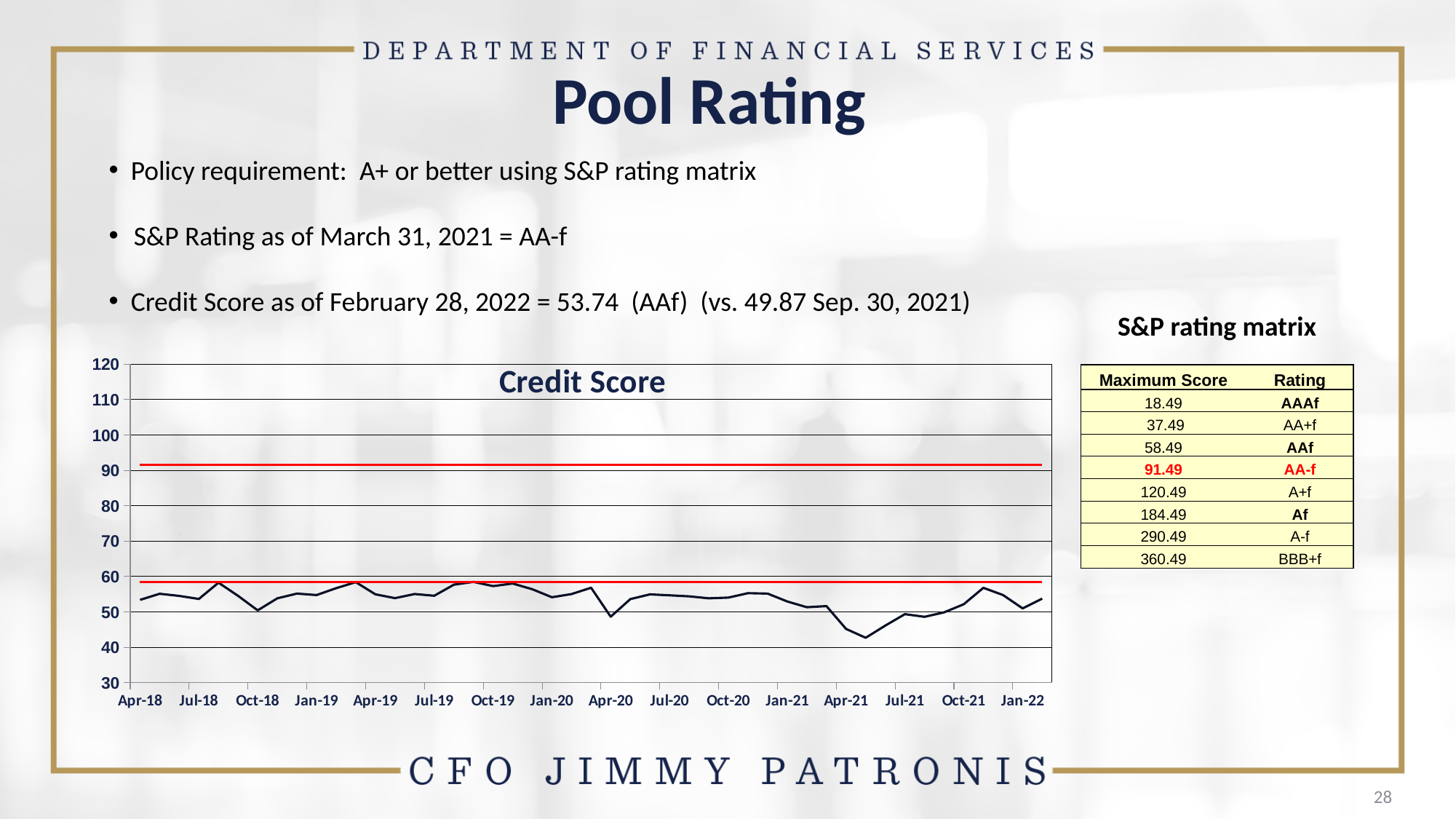
Does the credit score line ever rise above 70 on the chart? No Which has the higher credit score, Apr-18 or Apr-21? Apr-18 Which has the higher credit score, Oct-18 or Oct-19? Oct-19 What is the highest value shown on the y axis of the Credit Score chart? 120 Does the credit score line generally rise or fall from Jan-21 to Apr-21? fall What is the title of the chart on the slide? Credit Score Is the credit score for Apr-21 greater or less than 50? less How many date labels are shown along the x axis of the Credit Score chart? 16 What kind of chart is the Credit Score chart? line chart Does the credit score line generally rise or fall from Apr-21 to Oct-21? rise Is the credit score for Oct-19 greater or less than 50? greater